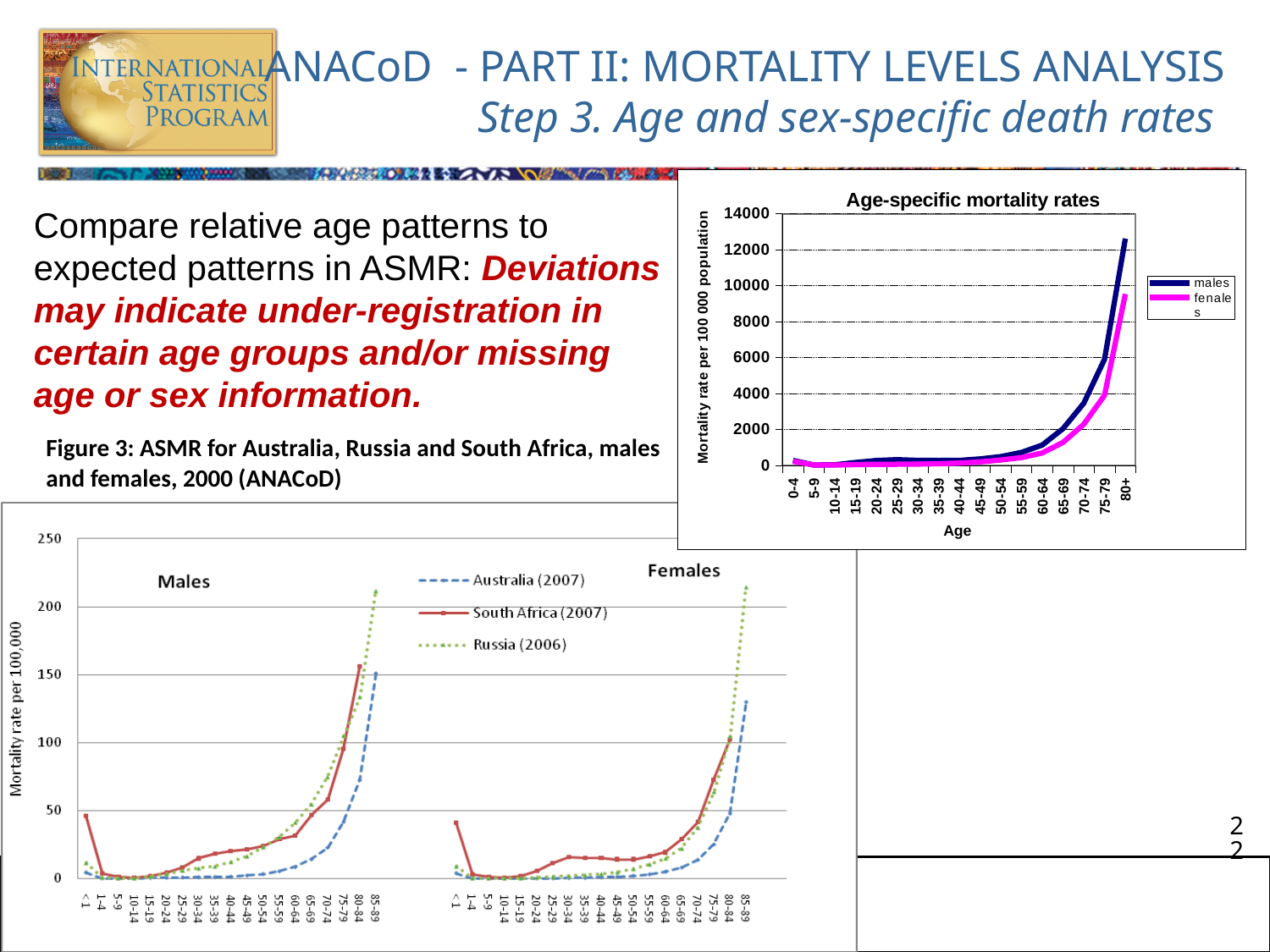
In the 'Age-specific mortality rates' chart, what kind of chart is shown? line chart In the bottom chart (Figure 3), is the value for South Africa (2007) males at age 80-84 greater or less than 100? greater In the 'Age-specific mortality rates' chart, how many series does the legend list? 2 In the bottom chart (Figure 3), is the value for Russia (2006) males at age 85-89 greater or less than 200? greater In the 'Age-specific mortality rates' chart, is the value for males at 80+ greater or less than 10000? greater In the 'Age-specific mortality rates' chart, which series has the higher value at 80+, males or females? males In the 'Age-specific mortality rates' chart, what is the label of the y axis? Mortality rate per 100 000 population In the bottom chart (Figure 3: ASMR for Australia, Russia and South Africa), how many series does the legend list? 3 In the 'Age-specific mortality rates' chart, how many age categories are shown on the x axis? 17 In the 'Age-specific mortality rates' chart, do the mortality rates generally rise or fall as age increases from 15-19 to 80+? rise In the bottom chart (Figure 3), which country has the highest value for males at age 85-89? Russia (2006)